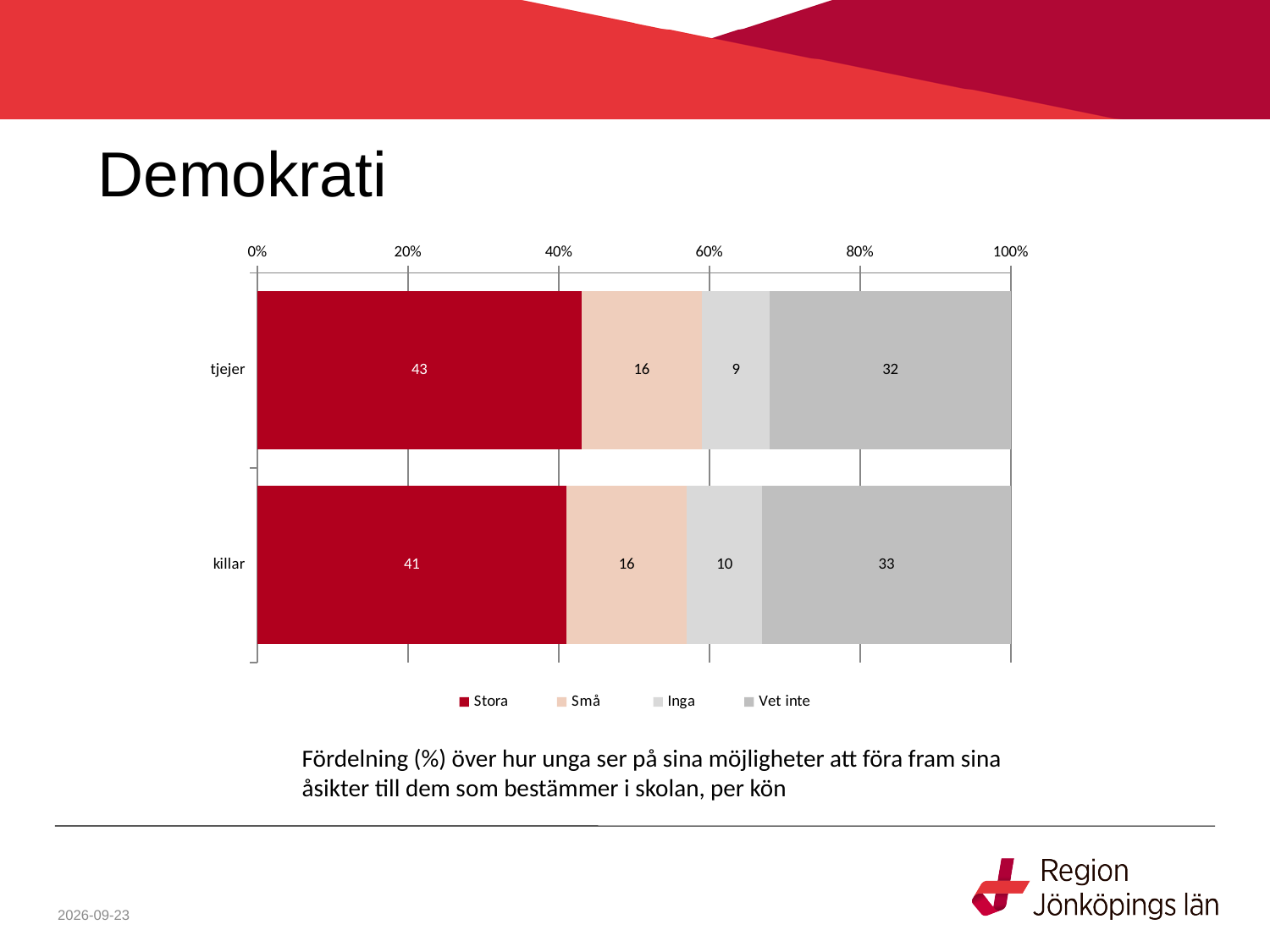
What is the value for Små for killar? 16 What is the value for Vet inte for killar? 33 What is the difference between the Stora values for tjejer and killar? 2 How many categories are shown on the y axis? 2 Which series is shown in dark red in the legend? Stora What is the difference between the Vet inte values for killar and tjejer? 1 Which category has the higher value for Stora, tjejer or killar? tjejer What is the value for Inga for tjejer? 9 How many series does the legend list? 4 What is the value for Stora for tjejer? 43 What kind of chart is shown on the slide? stacked bar chart What is the total of the stacked bar for tjejer? 100